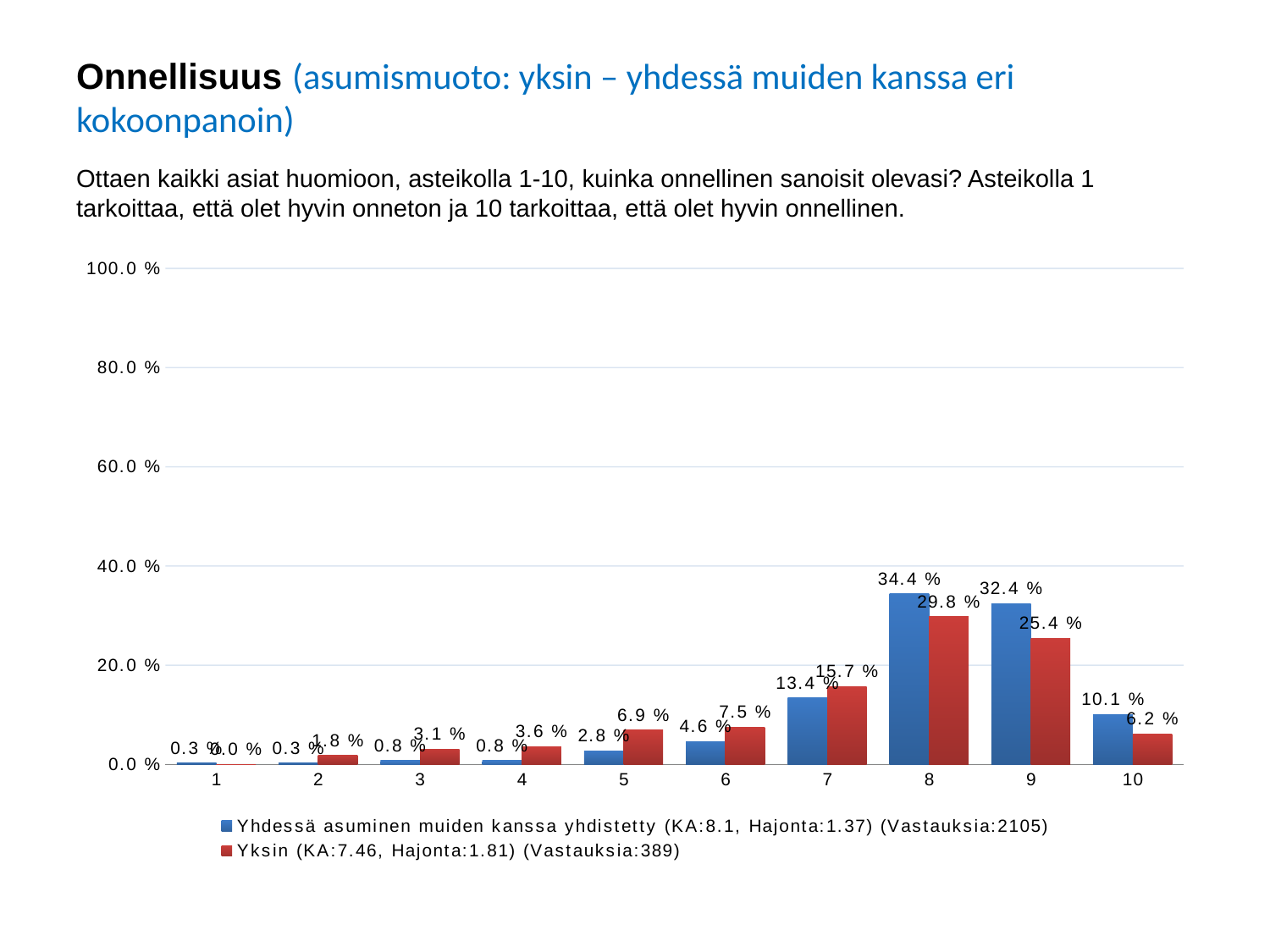
What is the value for category 10 in the Yhdessä asuminen muiden kanssa yhdistetty series? 10.1 % For category 6, which series has the larger value, Yhdessä asuminen muiden kanssa yhdistetty or Yksin? Yksin What is the value for category 9 in the Yksin series? 25.4 % What is the value for category 7 in the Yksin series? 15.7 % What is the difference between the Yhdessä asuminen muiden kanssa yhdistetty and Yksin values for category 9? 7.0 % Which category has the highest value in the Yhdessä asuminen muiden kanssa yhdistetty series? 8 Is the value for category 8 in the Yksin series greater or less than 20.0 %? greater What is the value for category 8 in the Yhdessä asuminen muiden kanssa yhdistetty series? 34.4 % How many series does the legend list? 2 How many categories are shown on the x axis? 10 Which category has the highest value in the Yksin series? 8 What kind of chart is shown on the slide? bar chart